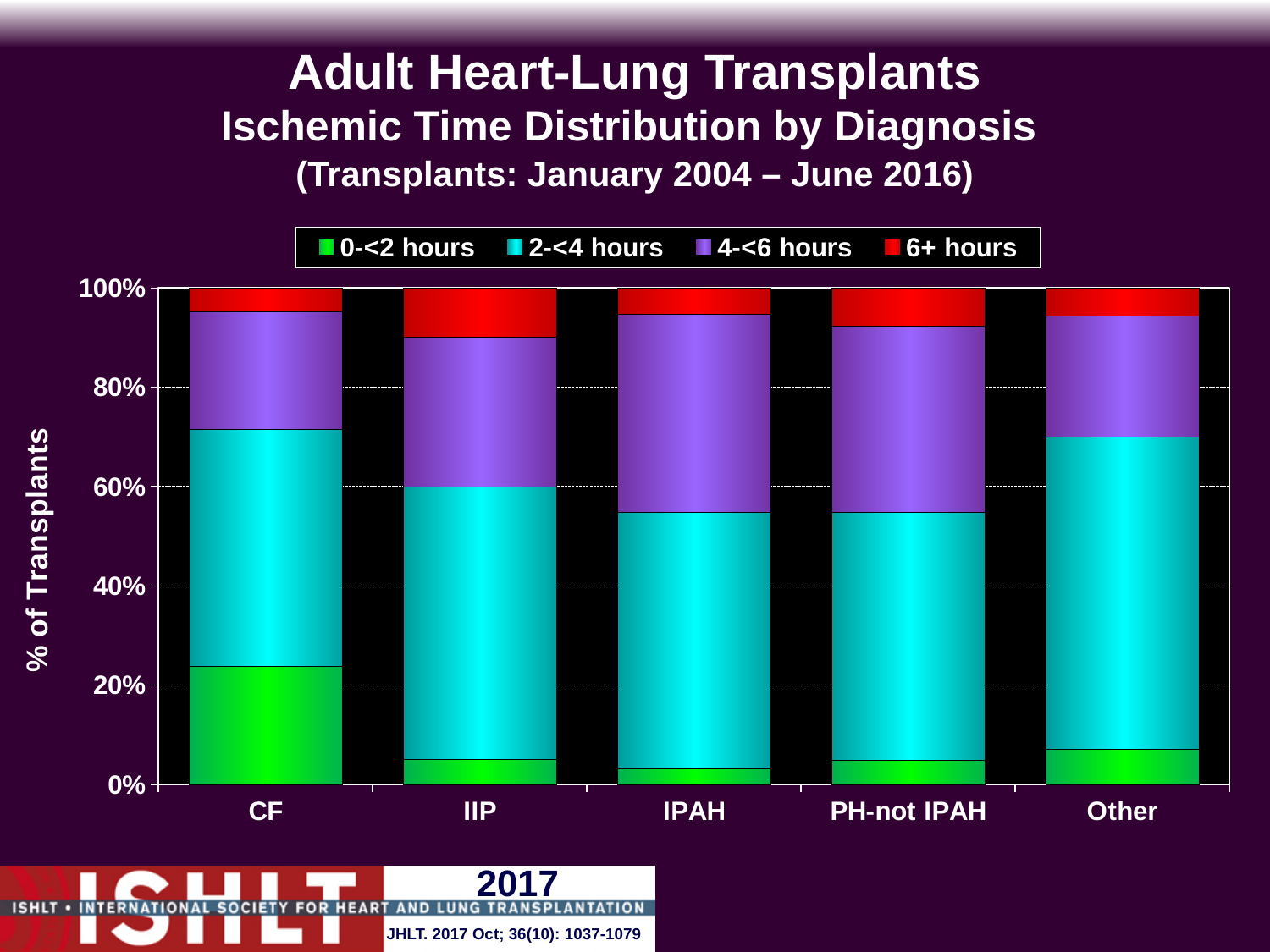
What is the total height of each stacked bar? 100% Which diagnosis category has the largest 6+ hours segment? IIP What kind of chart is shown on the slide? Stacked bar chart Is the 0-<2 hours segment for CF larger or smaller than the 0-<2 hours segment for IIP? larger Is the 6+ hours share for IIP greater or less than 20%? less How many series does the legend list? 4 Which diagnosis category has the largest 0-<2 hours segment? CF Is the 6+ hours segment for IIP larger or smaller than the 6+ hours segment for CF? larger What is the label on the y axis? % of Transplants How many diagnosis categories are shown on the x axis? 5 Is the 0-<2 hours share for CF greater or less than 20%? greater What time range does the legend entry shown in red represent? 6+ hours